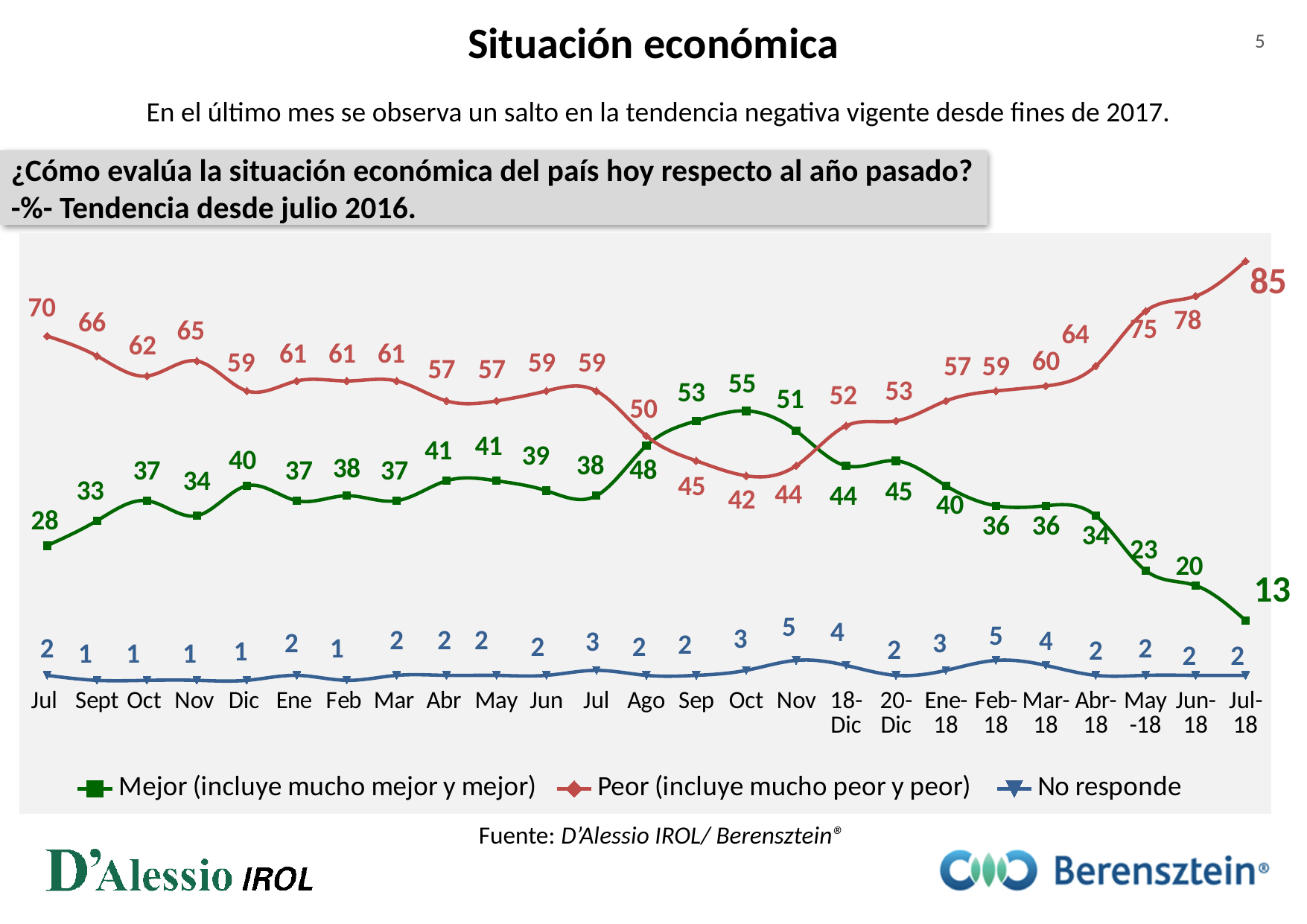
How many series does the legend list? 3 What is the difference between the Peor and Mejor values at Jul-18? 72 Does the Peor series rise or fall from Ene-18 to Jul-18? Rises What is the value of the Peor series at Jul-18? 85 At Sep (2017), which series is larger, Mejor or Peor? Mejor How many points are plotted along the x axis for each series? 25 What kind of chart is shown on the slide? Line chart What is the value of the Mejor series at 18-Dic? 44 What is the value of the No responde series at Feb-18? 5 What is the value of the Mejor series at the first Jul point (leftmost)? 28 At which x-axis point does the Peor series reach its highest value? Jul-18 At which x-axis point does the Mejor series reach its lowest value? Jul-18